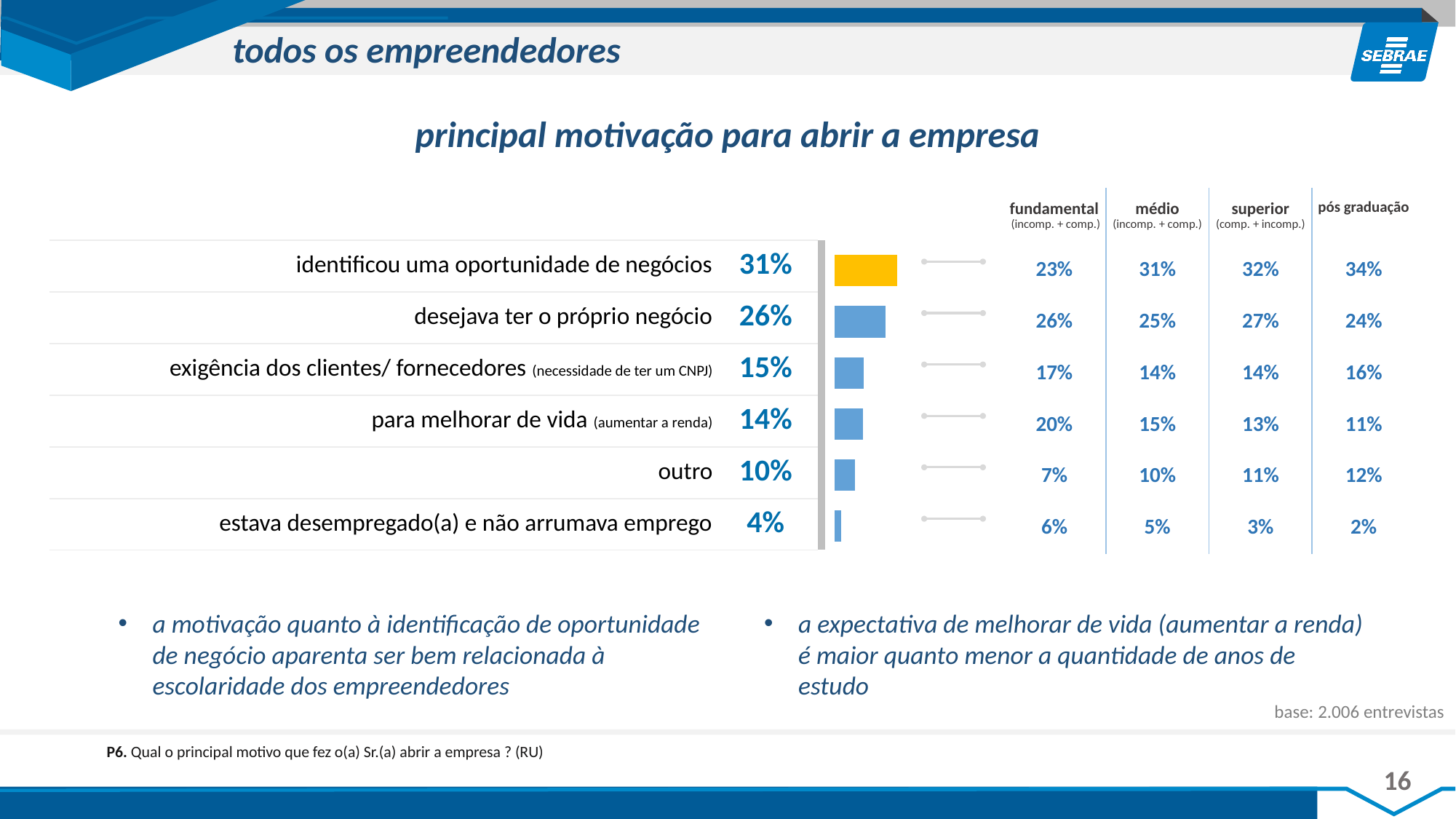
What is the value shown for "outro"? 10% Which has a larger value: "exigência dos clientes/ fornecedores" or "para melhorar de vida"? exigência dos clientes/ fornecedores In the table by education level, what percentage of entrepreneurs with "fundamental" education cited "para melhorar de vida"? 20% What colour is the bar for the highest category, "identificou uma oportunidade de negócios"? Yellow What percentage of entrepreneurs cited "identificou uma oportunidade de negócios" as their main motivation? 31% Which motivation has the highest percentage in the bar chart? identificou uma oportunidade de negócios What type of chart is used to show the main motivation for opening the company? Bar chart How many motivation categories are shown in the bar chart? 6 What is the difference in percentage points between "identificou uma oportunidade de negócios" and "desejava ter o próprio negócio"? 5 percentage points What is the value shown for "desejava ter o próprio negócio"? 26% Which motivation has the lowest percentage in the bar chart? estava desempregado(a) e não arrumava emprego In the table by education level, what percentage of entrepreneurs with "pós graduação" cited "identificou uma oportunidade de negócios"? 34%